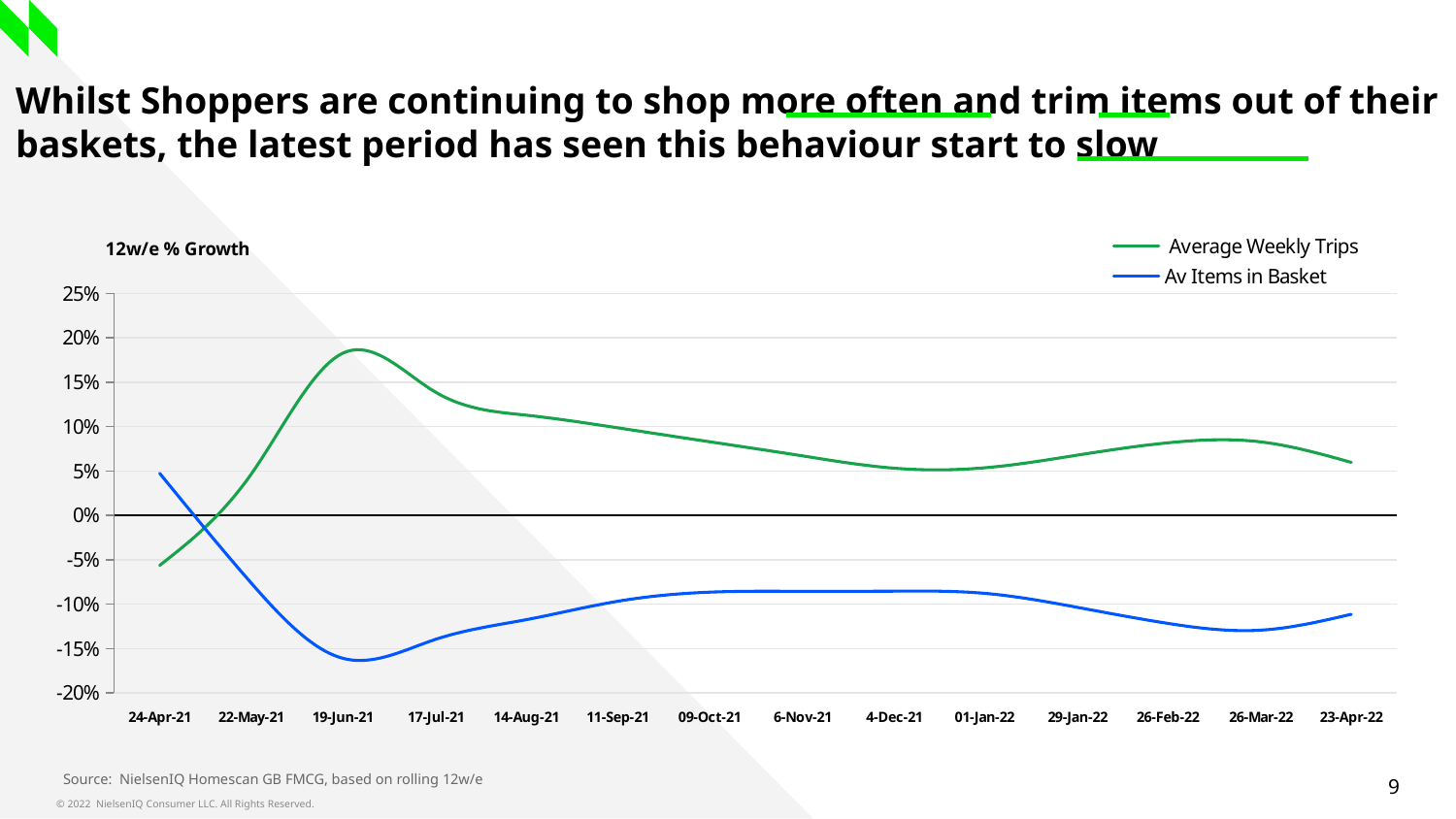
At 23-Apr-22, which series has the higher value, Average Weekly Trips or Av Items in Basket? Average Weekly Trips Is the value for Average Weekly Trips at 19-Jun-21 greater or less than 15%? greater At which date does the Av Items in Basket series reach its lowest value? 19-Jun-21 Is the value for Average Weekly Trips at 24-Apr-21 greater or less than 0%? less Is the value for Average Weekly Trips at 4-Dec-21 greater or less than 10%? less How many series does the legend list? 2 What kind of chart is shown on the slide? line chart How many dates are shown along the x axis? 14 At which date is the Average Weekly Trips series at its lowest value? 24-Apr-21 Does the Av Items in Basket series rise or fall between 24-Apr-21 and 19-Jun-21? fall At which date does the Average Weekly Trips series reach its highest value? 19-Jun-21